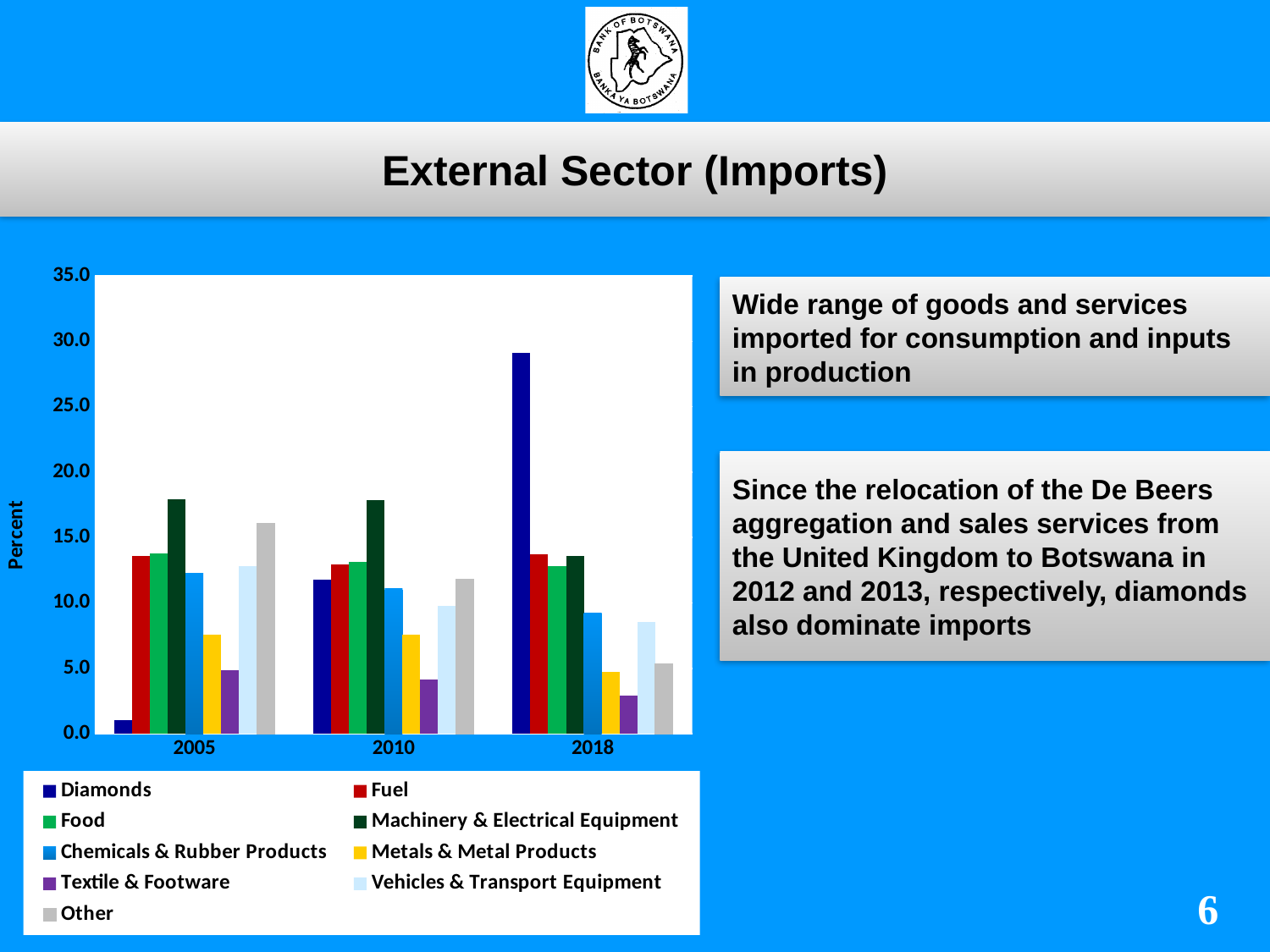
How many series does the chart's legend list? 9 Which series has the highest value in 2018? Diamonds Is the value for Diamonds in 2018 greater or less than 25.0? greater What kind of chart is shown on the slide? bar chart What is the label on the chart's vertical axis? Percent How many years are shown on the x axis of the chart? 3 Do the values for Other rise or fall from 2005 to 2018? fall Is the value for Machinery & Electrical Equipment in 2005 greater or less than 15.0? greater Is the value for Textile & Footware in 2018 greater or less than 5.0? less Which series has the lowest value in 2005? Diamonds Do the values for Diamonds rise or fall from 2005 to 2018? rise Which series has the highest value in 2010? Machinery & Electrical Equipment